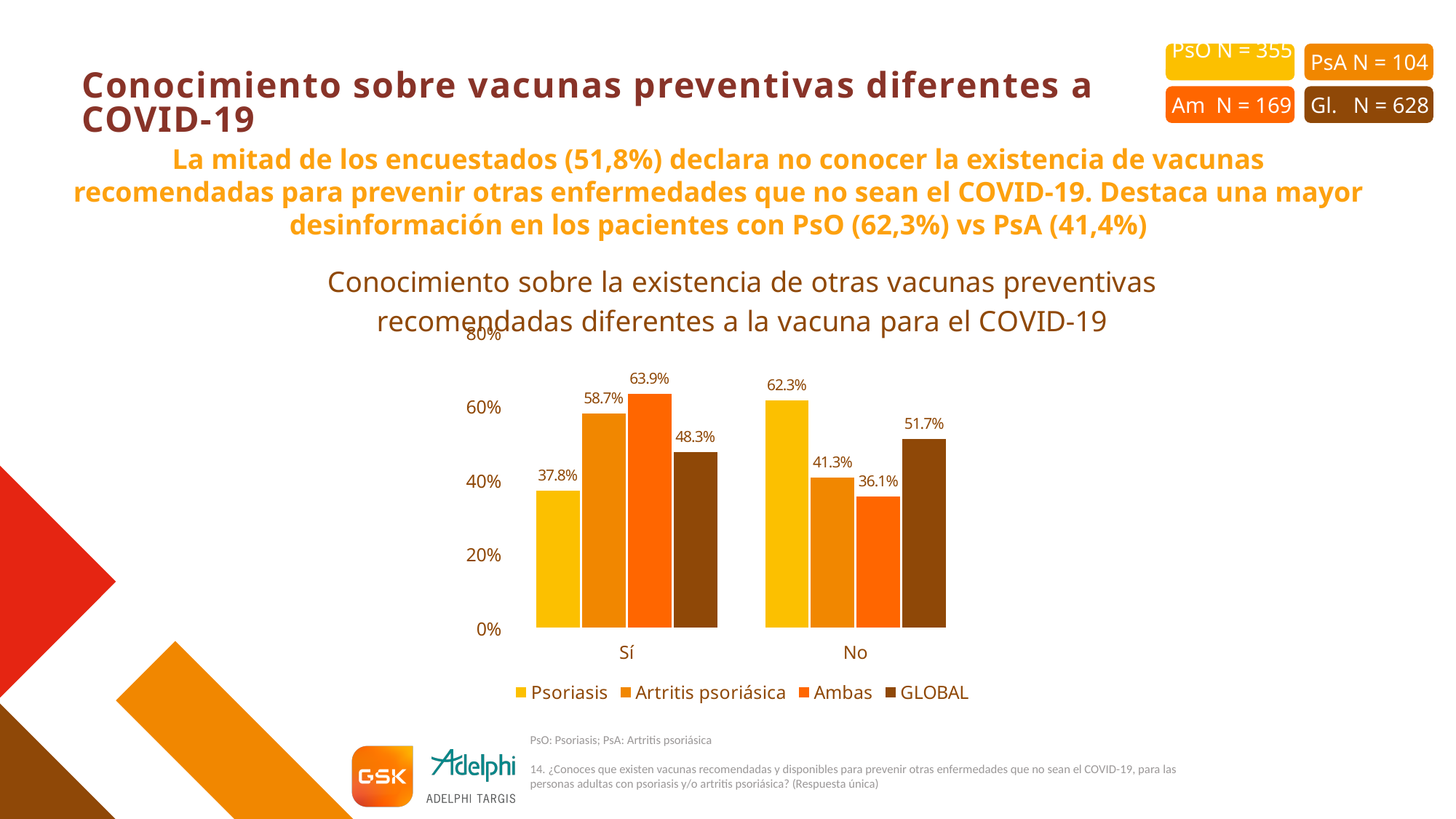
What is the value for Artritis psoriásica in the Sí category? 58.7% What is the GLOBAL value for the No category? 51.7% Which series has the lowest value in the No category? Ambas What is the value for Ambas in the No category? 36.1% Which series has the highest value in the Sí category? Ambas Which is larger: the Artritis psoriásica value for Sí or for No? Sí What is the difference between the Psoriasis values for No and Sí? 24.5% What is the difference between the GLOBAL values for No and Sí? 3.4% What kind of chart is shown on the slide? Bar chart How many categories are shown on the x axis? 2 How many series does the legend list? 4 What is the value for Psoriasis in the Sí category? 37.8%